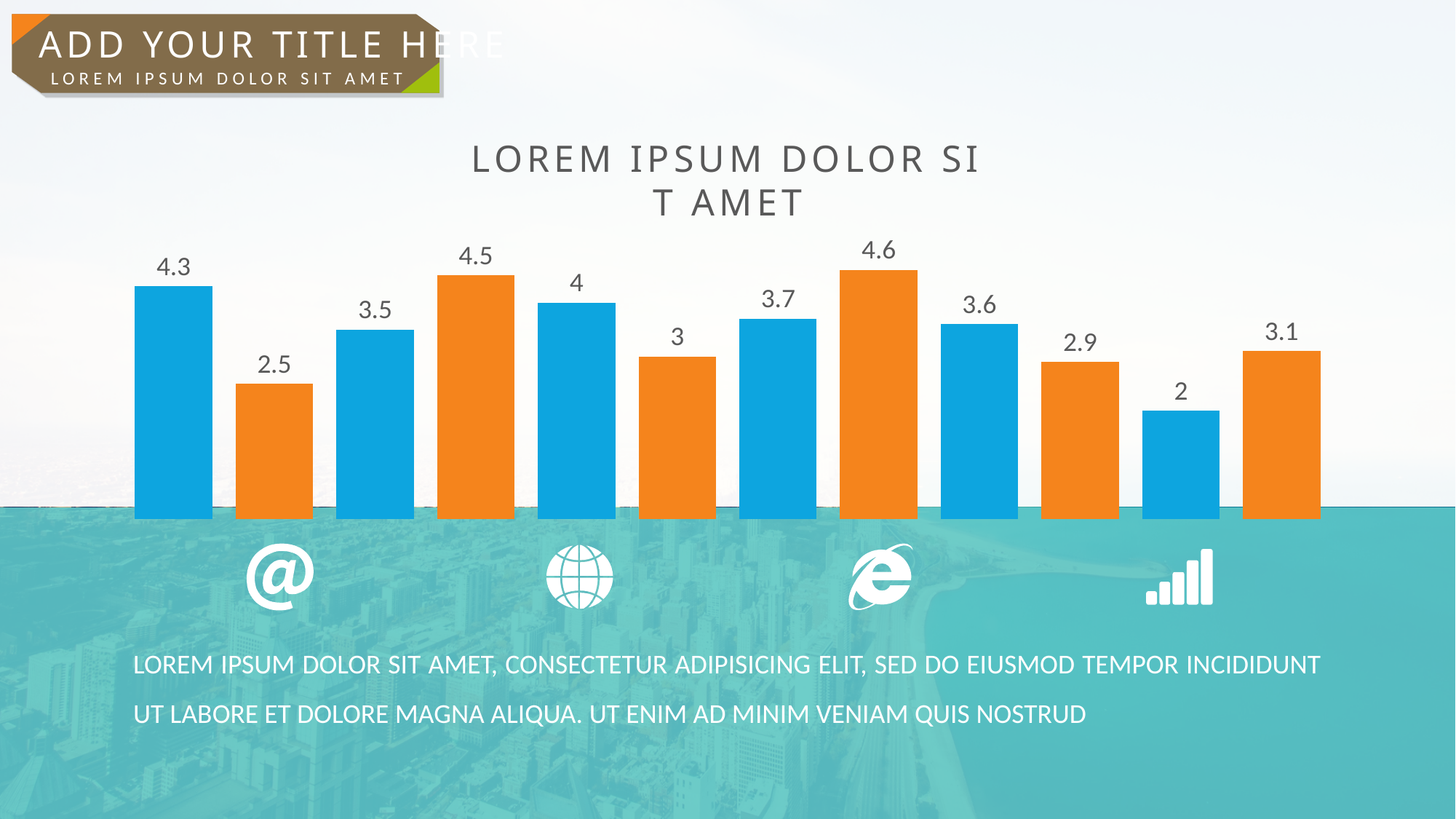
What is the value of the fourth bar from the left in the chart? 4.5 What is the highest value shown in the chart? 4.6 What is the value of the last (rightmost) bar in the chart? 3.1 What is the value of the first (leftmost) bar in the chart? 4.3 What is the lowest value shown in the chart? 2 How many bars are plotted in the chart? 12 What two colours are used for the bars in the chart? blue and orange What is the difference between the highest bar (4.6) and the lowest bar (2) in the chart? 2.6 What is the difference between the first bar (4.3) and the second bar (2.5) in the chart? 1.8 What kind of chart is shown on the slide? bar chart What is the title of the chart? LOREM IPSUM DOLOR SI T AMET Which is larger, the fifth bar from the left or the sixth bar from the left? the fifth bar (4)